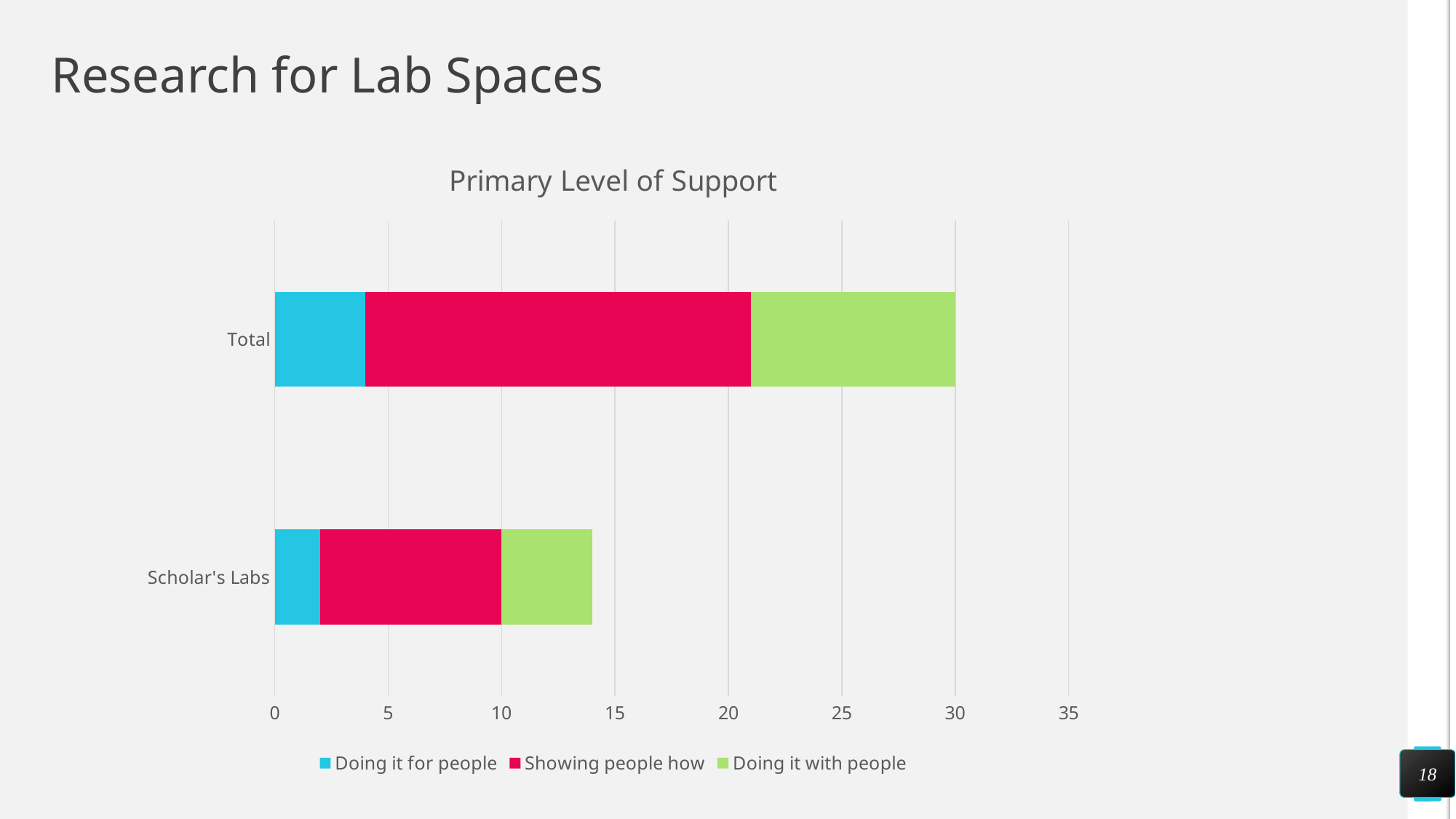
What is the title of the chart? Primary Level of Support Which series has the largest segment in the Scholar's Labs bar? Showing people how Is the total stacked value for Total greater or less than 25? greater What is the total length of the stacked bar for Total? 30 What kind of chart is shown on the slide? bar chart How many categories are shown on the vertical axis? 2 Is the value of Doing it for people for Total greater or less than 5? less Is the total stacked value for Scholar's Labs greater or less than 15? less Which series is shown in green in the legend? Doing it with people How many series does the legend list? 3 Which category has the longer stacked bar, Total or Scholar's Labs? Total